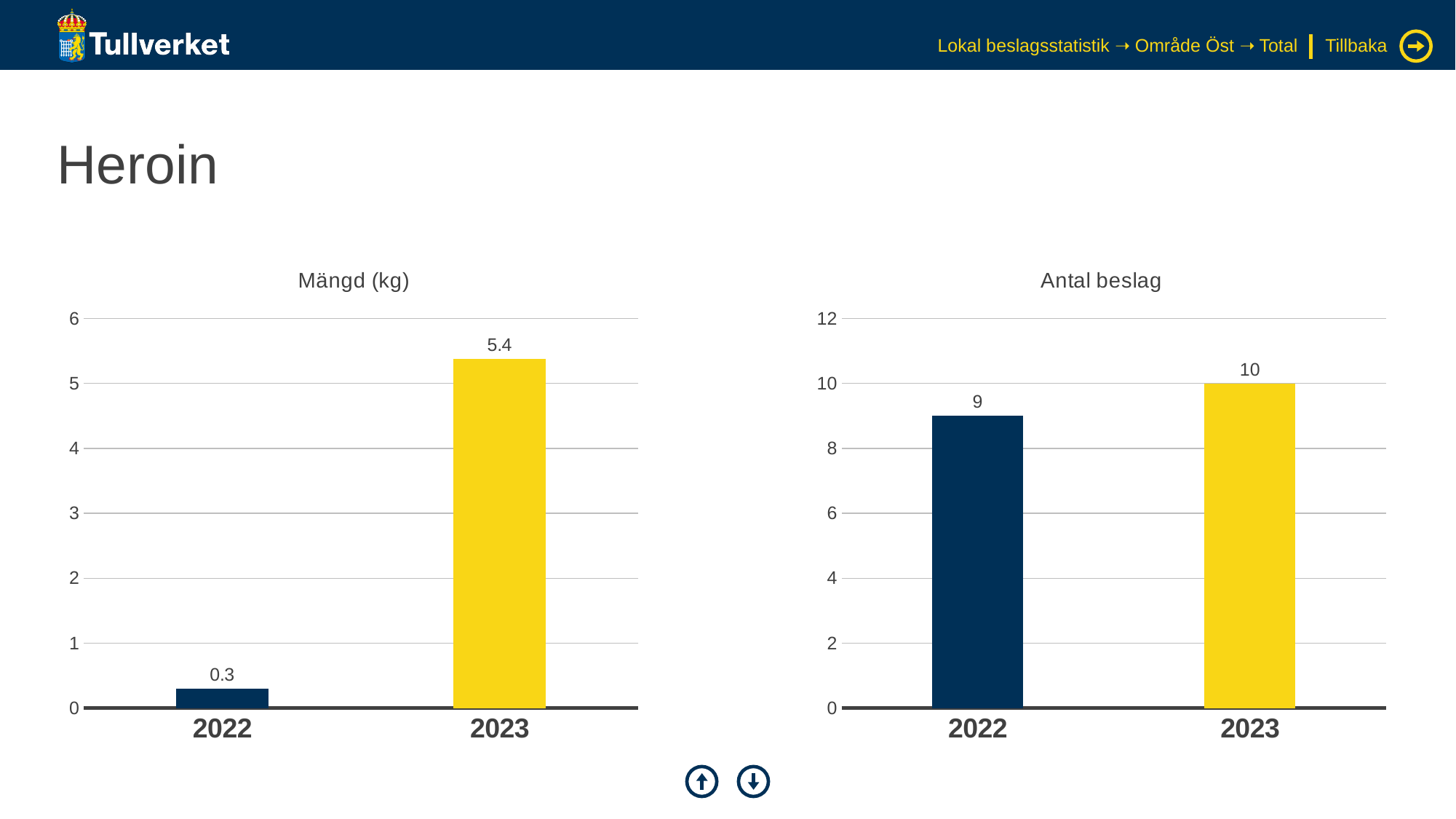
In the 'Antal beslag' chart, which is larger, the value for 2022 or 2023? 2023 In the 'Mängd (kg)' chart, what is the value for 2023? 5.4 In the 'Mängd (kg)' chart, what is the value for 2022? 0.3 In the 'Mängd (kg)' chart, what is the difference between the 2023 and 2022 values? 5.1 How many categories are shown on the x axis of the 'Antal beslag' chart? 2 In the 'Antal beslag' chart, which year has the lowest value? 2022 In the 'Mängd (kg)' chart, is the value for 2023 greater or less than 5? greater In the 'Antal beslag' chart, what is the value for 2023? 10 What kind of chart is the 'Mängd (kg)' chart? bar chart In the 'Mängd (kg)' chart, which year has the highest value? 2023 In the 'Antal beslag' chart, what is the difference between the 2023 and 2022 values? 1 In the 'Antal beslag' chart, what is the value for 2022? 9